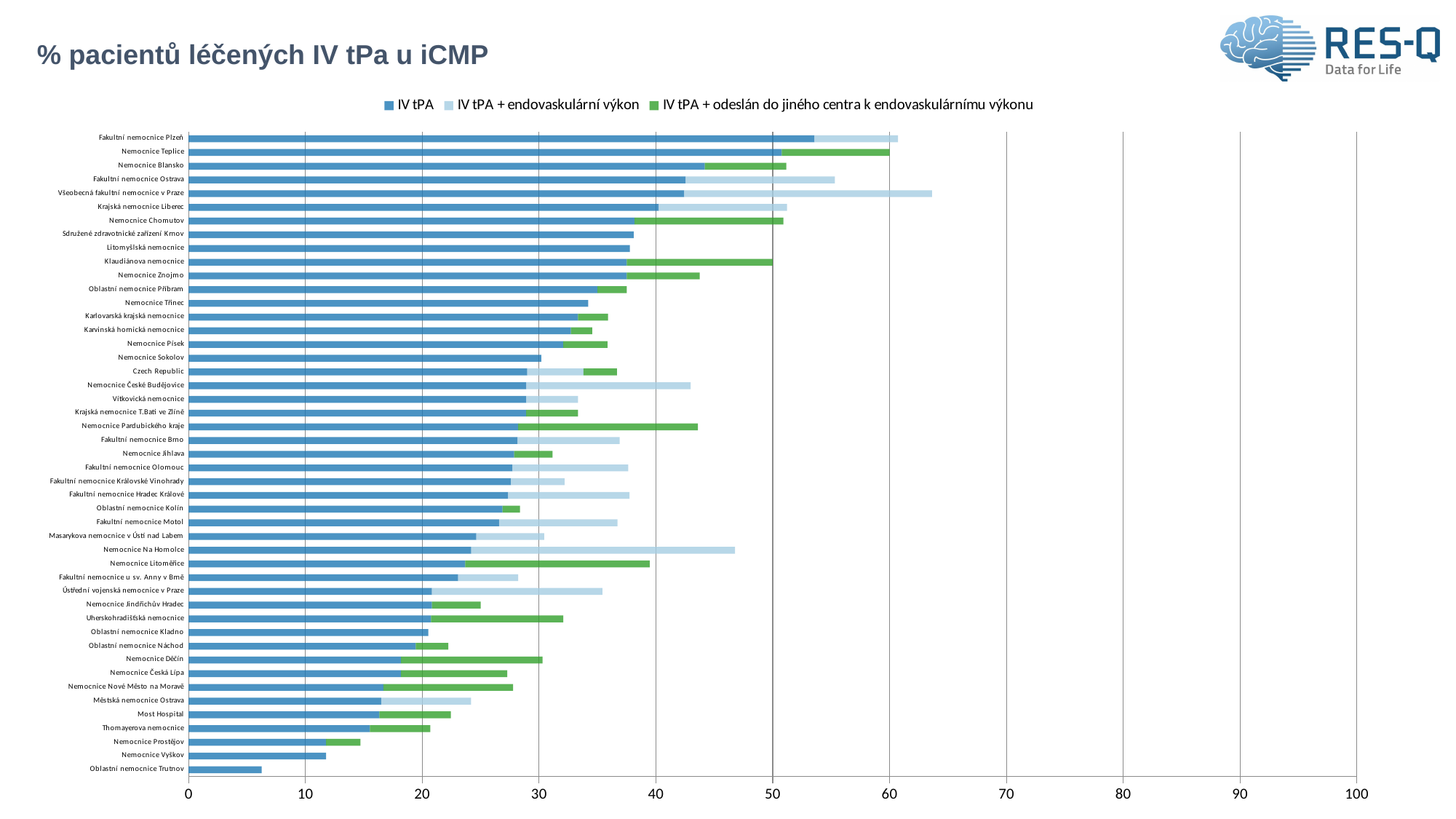
Is the IV tPA value for Fakultní nemocnice Plzeň greater or less than 50? greater Is the IV tPA value for Oblastní nemocnice Trutnov greater or less than 10? less Is the IV tPA value for Nemocnice Vyškov greater or less than 20? less What kind of chart is shown on the slide? bar chart Which has the longer total stacked bar, Nemocnice Na Homolce or Nemocnice Litoměřice? Nemocnice Na Homolce Which series is shown in green in the legend? IV tPA + odeslán do jiného centra k endovaskulárnímu výkonu What is the title of the chart? % pacientů léčených IV tPa u iCMP Which hospital has the lowest IV tPA value? Oblastní nemocnice Trutnov Do the IV tPA values rise or fall going from the top of the chart to the bottom? fall How many series does the legend list? 3 Which hospital has the highest IV tPA value? Fakultní nemocnice Plzeň